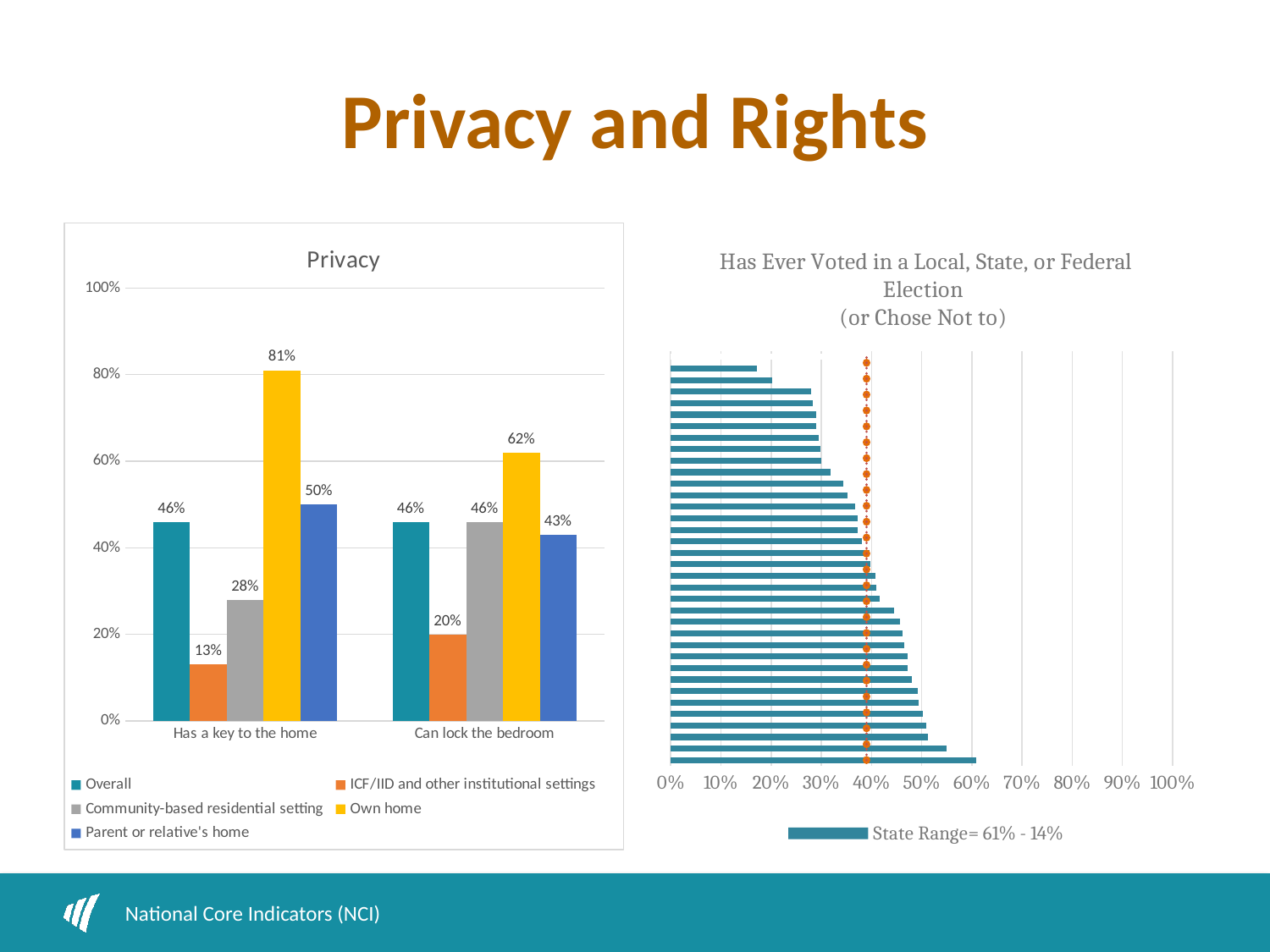
In the Privacy chart, which is larger for Community-based residential setting: 'Has a key to the home' or 'Can lock the bedroom'? Can lock the bedroom In the Privacy chart, which series has the highest value for 'Can lock the bedroom'? Own home In the Privacy chart, what is the value for Own home for 'Has a key to the home'? 81% How many categories are shown on the x axis of the Privacy chart? 2 What state range does the legend of the 'Has Ever Voted in a Local, State, or Federal Election' chart give? 61% - 14% In the Privacy chart, what is the value for Parent or relative's home for 'Has a key to the home'? 50% How many series does the legend of the Privacy chart list? 5 In the Privacy chart, what is the difference between Own home and Overall for 'Has a key to the home'? 35% In the Privacy chart, what is the difference between Own home and Parent or relative's home for 'Can lock the bedroom'? 19% What kind of chart is the 'Has Ever Voted in a Local, State, or Federal Election' chart? Bar chart In the Privacy chart, which series has the lowest value for 'Has a key to the home'? ICF/IID and other institutional settings In the Privacy chart, what is the value for ICF/IID and other institutional settings for 'Can lock the bedroom'? 20%